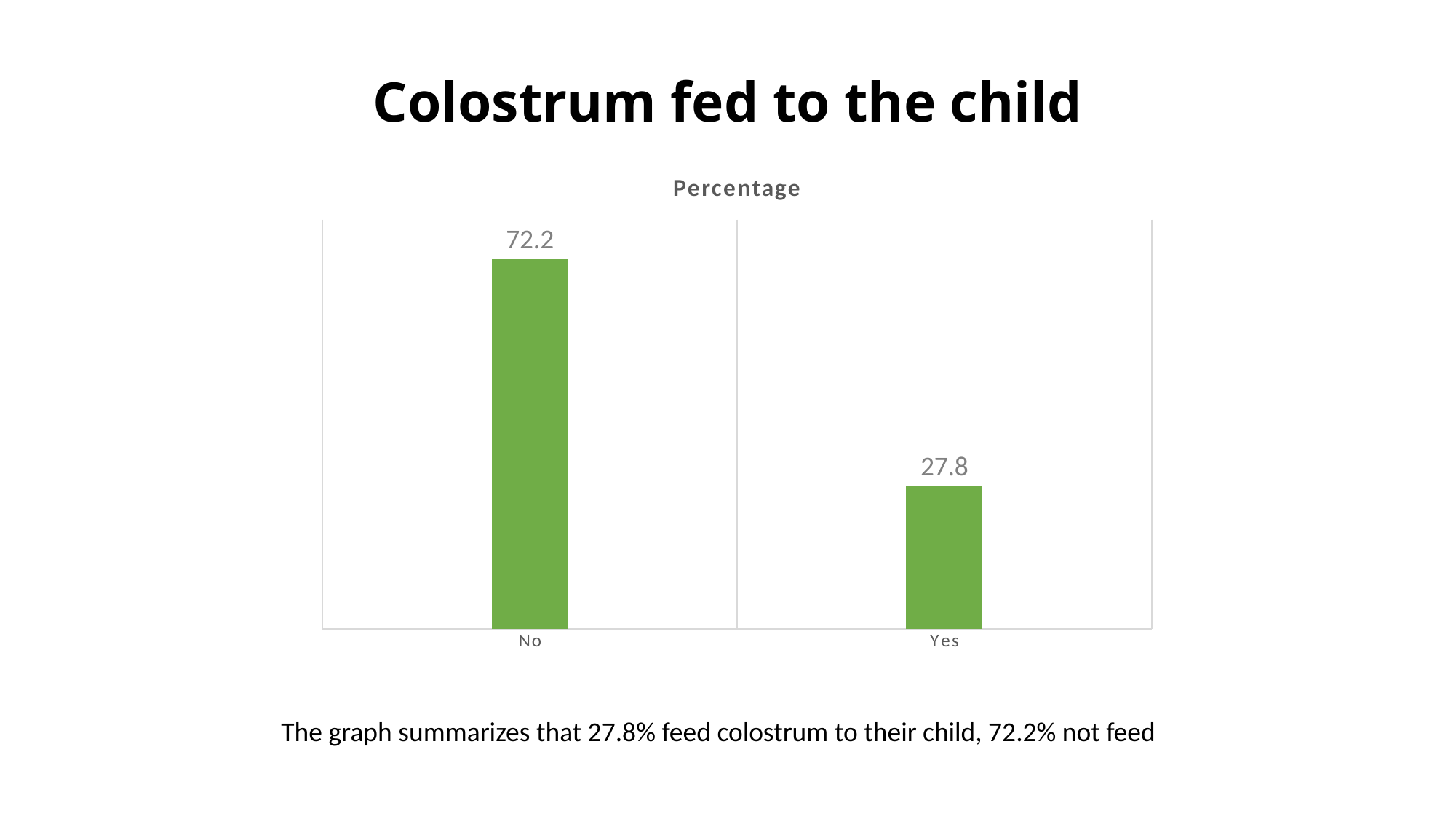
What kind of chart is shown on the slide? Bar chart What is the value for the "Yes" category? 27.8 How many categories are shown on the x axis? 2 What colour are the bars in the chart? Green Do the values rise or fall from left to right along the x axis? Fall What is the value for the "No" category? 72.2 Which is larger, the value for "No" or the value for "Yes"? No What is the difference between the values for "No" and "Yes"? 44.4 What is the title of the chart? Percentage Which category has the highest value? No Which category has the lowest value? Yes